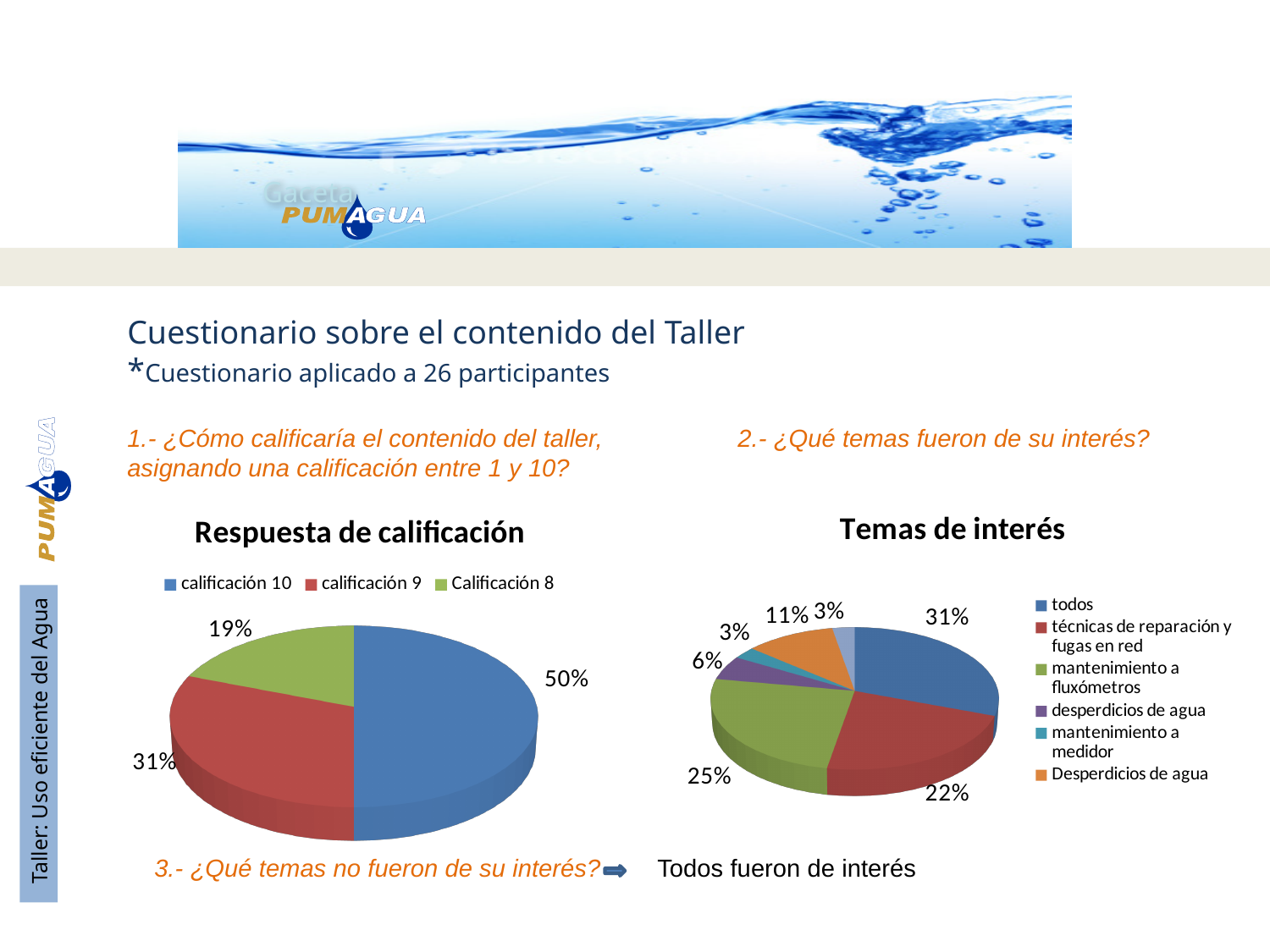
In the 'Respuesta de calificación' chart, which category has the smallest share? Calificación 8 In the 'Temas de interés' chart, which has the larger share: 'todos' or 'mantenimiento a fluxómetros'? todos How many entries does the legend of the 'Respuesta de calificación' chart list? 3 What kind of chart is 'Respuesta de calificación'? pie chart In the 'Respuesta de calificación' chart, what is the difference between the shares for calificación 10 and calificación 9? 19% In the 'Temas de interés' chart, what share corresponds to 'técnicas de reparación y fugas en red'? 22% In the 'Respuesta de calificación' chart, what share corresponds to calificación 9? 31% In the 'Respuesta de calificación' chart, what share corresponds to calificación 10? 50% In the 'Temas de interés' chart, what share corresponds to 'todos'? 31% In the 'Respuesta de calificación' chart, what share corresponds to Calificación 8? 19% In the 'Temas de interés' chart, what share corresponds to 'mantenimiento a fluxómetros'? 25% What is the title of the pie chart on the right of the slide? Temas de interés